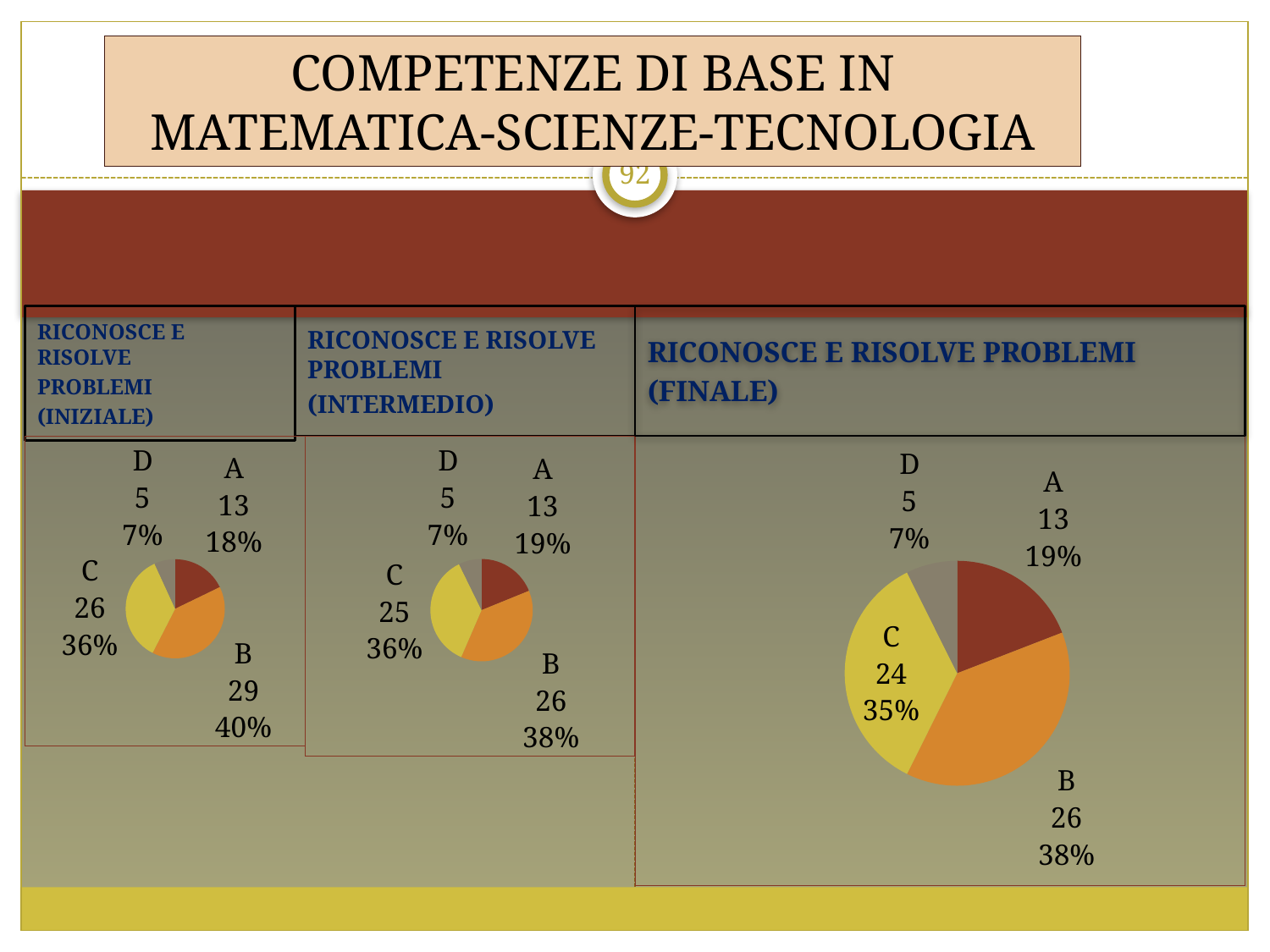
In the RICONOSCE E RISOLVE PROBLEMI (INTERMEDIO) chart, what is the difference between the values for B and A? 13 How many categories does the RICONOSCE E RISOLVE PROBLEMI (FINALE) chart show? 4 In the RICONOSCE E RISOLVE PROBLEMI (INTERMEDIO) chart, what share of the pie does A represent? 19% In the RICONOSCE E RISOLVE PROBLEMI (INIZIALE) chart, what is the value for B? 29 In the RICONOSCE E RISOLVE PROBLEMI (FINALE) chart, what is the value for C? 24 In the RICONOSCE E RISOLVE PROBLEMI (INIZIALE) chart, what share of the pie does C represent? 36% What kind of chart is used for RICONOSCE E RISOLVE PROBLEMI (FINALE)? Pie chart In the RICONOSCE E RISOLVE PROBLEMI (INIZIALE) chart, which category has the smallest slice? D In the RICONOSCE E RISOLVE PROBLEMI (FINALE) chart, which is larger, the value for B or the value for C? B In the RICONOSCE E RISOLVE PROBLEMI (INIZIALE) chart, which category has the largest slice? B In the RICONOSCE E RISOLVE PROBLEMI (FINALE) chart, what share of the pie does D represent? 7% In the RICONOSCE E RISOLVE PROBLEMI (INTERMEDIO) chart, what is the value for C? 25